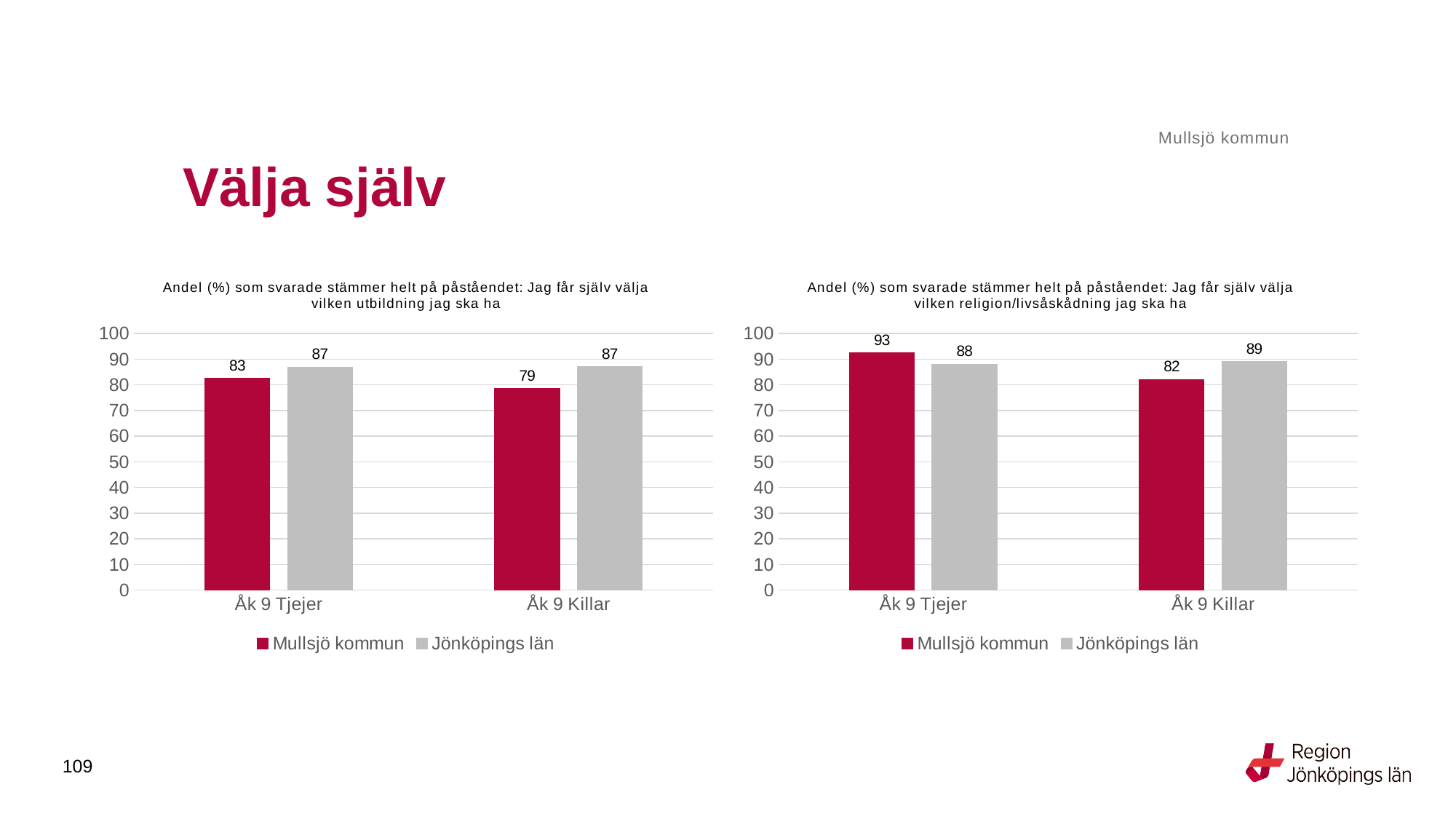
What kind of chart is the left chart? Bar chart In the left chart (about choosing education), what is the difference between Jönköpings län and Mullsjö kommun for Åk 9 Killar? 8 How many categories are shown on the x axis of the right chart? 2 In the right chart (about choosing religion/livsåskådning), what is the value for Jönköpings län for Åk 9 Killar? 89 In the left chart (about choosing education), which bar has the lowest value? Mullsjö kommun, Åk 9 Killar In the left chart (about choosing education), what is the value for Mullsjö kommun for Åk 9 Tjejer? 83 In the left chart (about choosing education), what is the value for Jönköpings län for Åk 9 Killar? 87 In the right chart (about choosing religion/livsåskådning), what is the difference between Mullsjö kommun and Jönköpings län for Åk 9 Tjejer? 5 In the right chart (about choosing religion/livsåskådning), what is the value for Mullsjö kommun for Åk 9 Tjejer? 93 In the right chart (about choosing religion/livsåskådning), which is larger for Åk 9 Killar: Mullsjö kommun or Jönköpings län? Jönköpings län In the right chart (about choosing religion/livsåskådning), which bar has the highest value? Mullsjö kommun, Åk 9 Tjejer How many series does the legend of the left chart list? 2